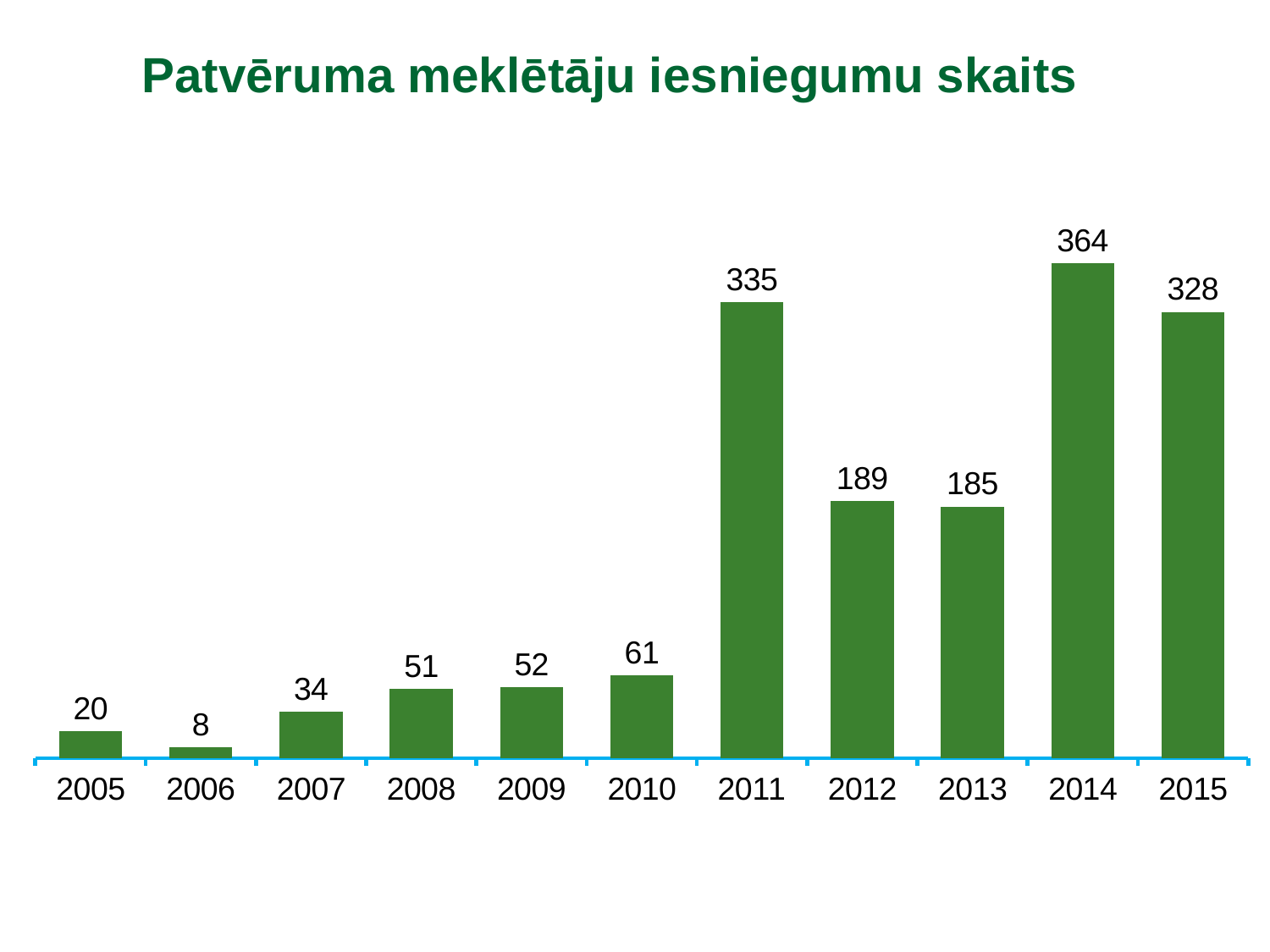
How many years are shown on the x axis? 11 What is the difference between the values for 2014 and 2015? 36 What is the difference between the values for 2011 and 2010? 274 What is the value for 2011? 335 What kind of chart is shown on the slide? bar chart What is the value for 2006? 8 Do the values rise or fall from 2005 to 2010? rise Which year has the lowest value? 2006 What is the value for 2013? 185 What is the title of the chart? Patvēruma meklētāju iesniegumu skaits Which is larger, the value for 2012 or the value for 2013? 2012 Which year has the highest value? 2014